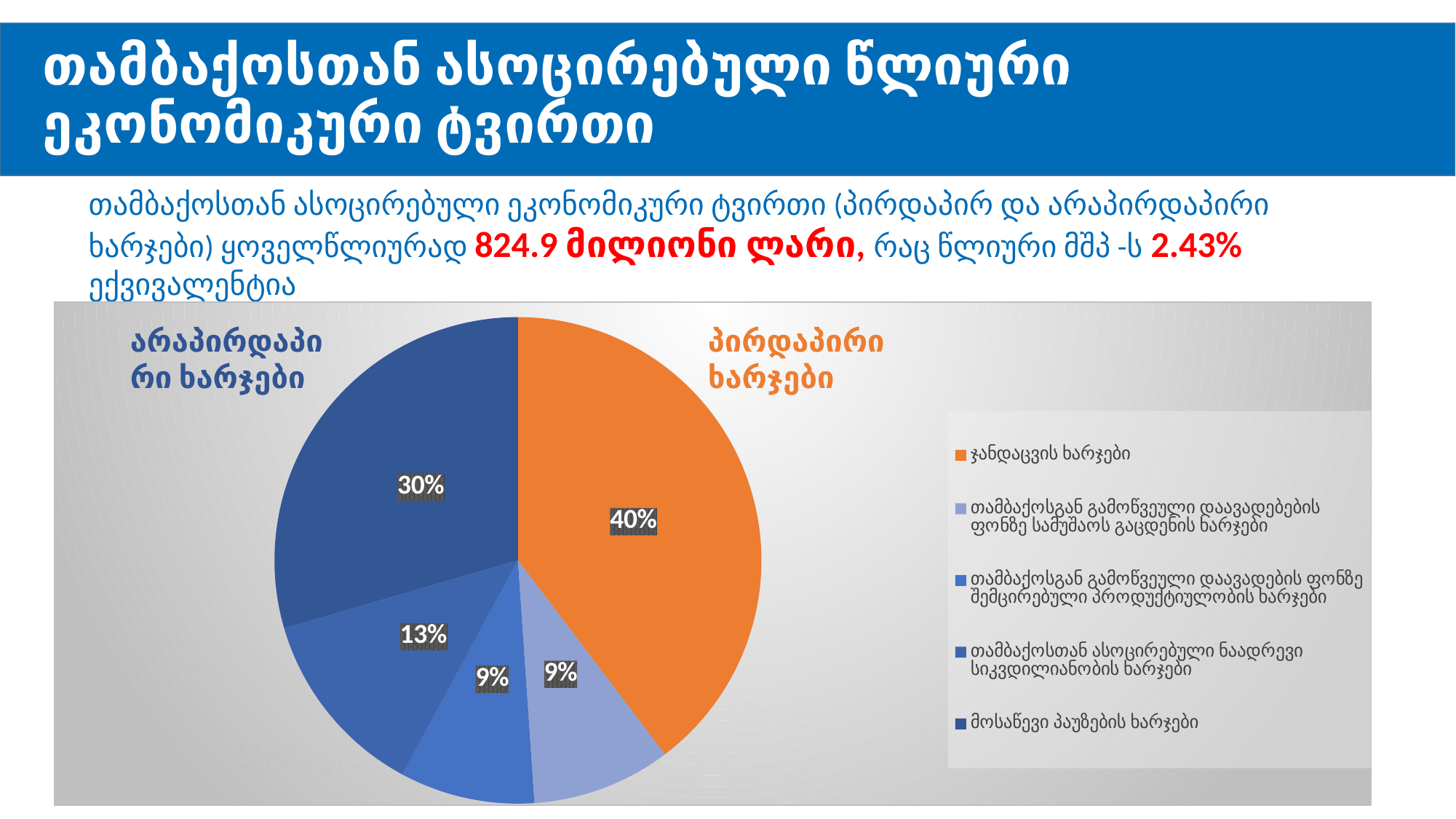
What colour is the slice for ჯანდაცვის ხარჯები? Orange What is the combined share of the two 9% slices and the 13% slice? 31% Which is larger: the slice for მოსაწევი პაუზების ხარჯები or the slice for თამბაქოსთან ასოცირებული ნაადრევი სიკვდილიანობის ხარჯები? მოსაწევი პაუზების ხარჯები What share of the pie does მოსაწევი პაუზების ხარჯები represent? 30% How many slices does the pie chart have? 5 What share of the pie does თამბაქოსგან გამოწვეული დაავადებების ფონზე სამუშაოს გაცდენის ხარჯები represent? 9% What share of the pie does ჯანდაცვის ხარჯები represent? 40% What kind of chart is shown on the slide? Pie chart How many entries does the legend list? 5 What is the difference in percentage points between ჯანდაცვის ხარჯები and მოსაწევი პაუზების ხარჯები? 10% Which category has the largest slice of the pie? ჯანდაცვის ხარჯები